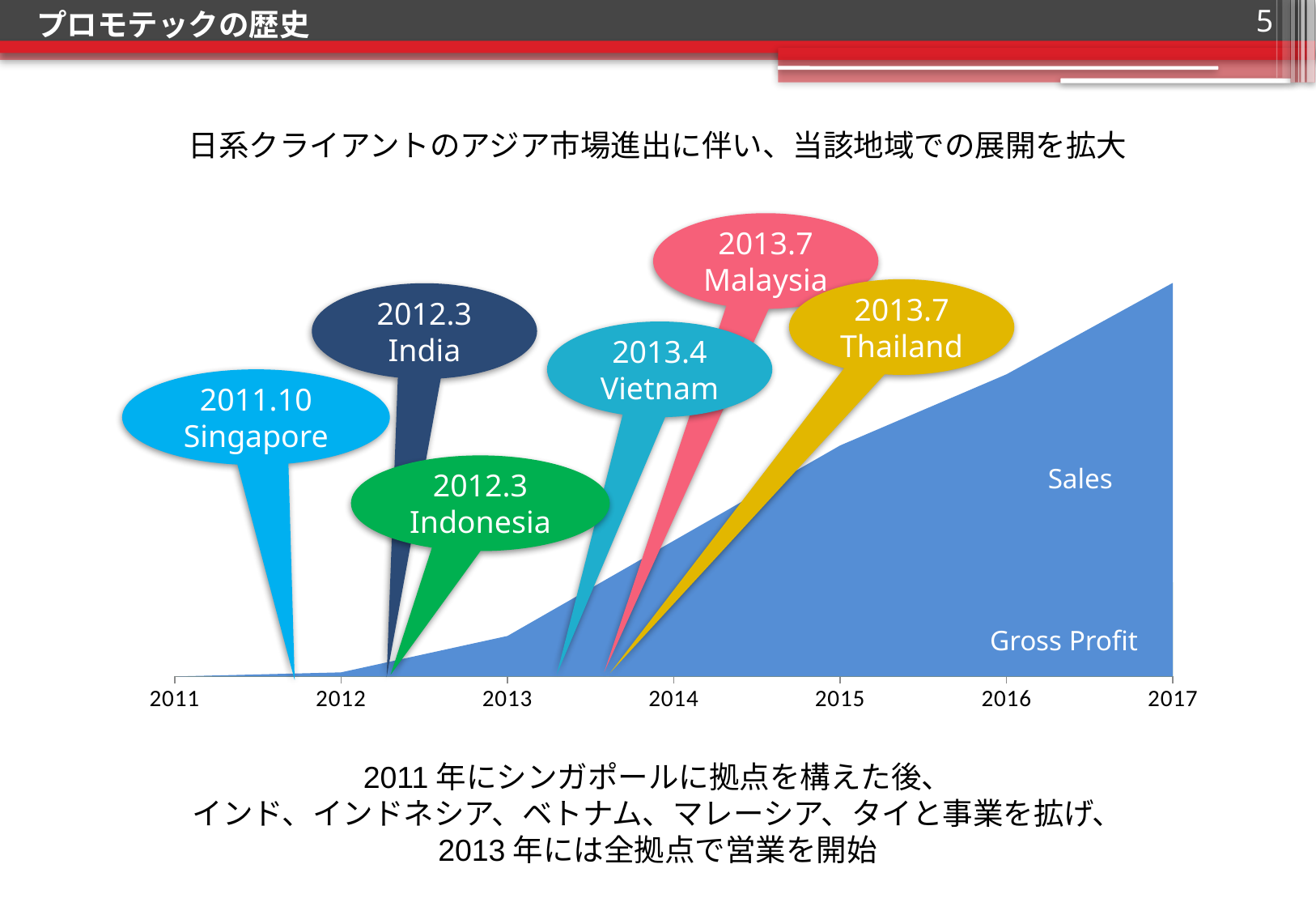
According to the callout on the chart, when was the Vietnam office opened? 2013.4 Which two countries share the opening date 2013.7 in the chart callouts? Malaysia and Thailand Which two countries share the opening date 2012.3 in the chart callouts? India and Indonesia According to the callouts on the chart, which country was opened first? Singapore What two series labels are written inside the shaded area of the chart? Sales and Gross Profit How many country callouts are placed on the chart? 6 What is the first year shown on the x axis of the chart? 2011 According to the callout on the chart, when was the Singapore office opened? 2011.10 How many year labels are shown on the x axis of the chart? 7 What kind of chart is shown on the slide? area chart What is the last year shown on the x axis of the chart? 2017 Do the plotted values rise or fall from 2011 to 2017 along the x axis? rise